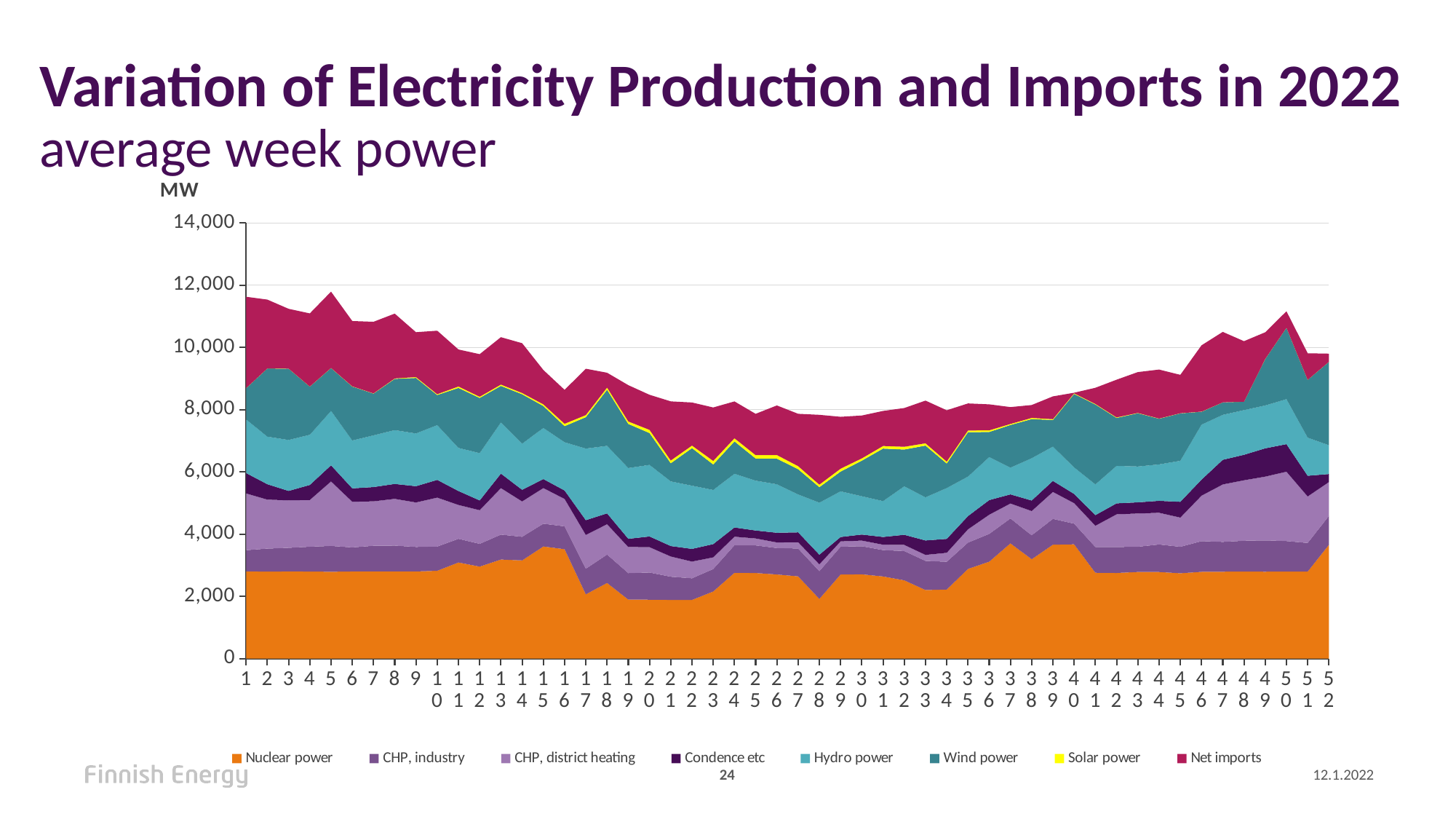
How many weeks are plotted along the x axis? 52 What kind of chart is shown on the slide? Stacked area chart Which week has the larger total stacked value, week 1 or week 28? Week 1 Which week has the larger Nuclear power value, week 19 or week 37? Week 37 Is the total stacked value for week 50 greater or less than 10,000? greater What unit is shown on the y axis? MW How many series does the legend list? 8 Is the total stacked value for week 28 greater or less than 10,000? less Is the Nuclear power value for week 1 greater or less than 4,000? less Does the total stacked value rise or fall from week 1 to week 28? Fall Which series is plotted at the bottom of the stack? Nuclear power